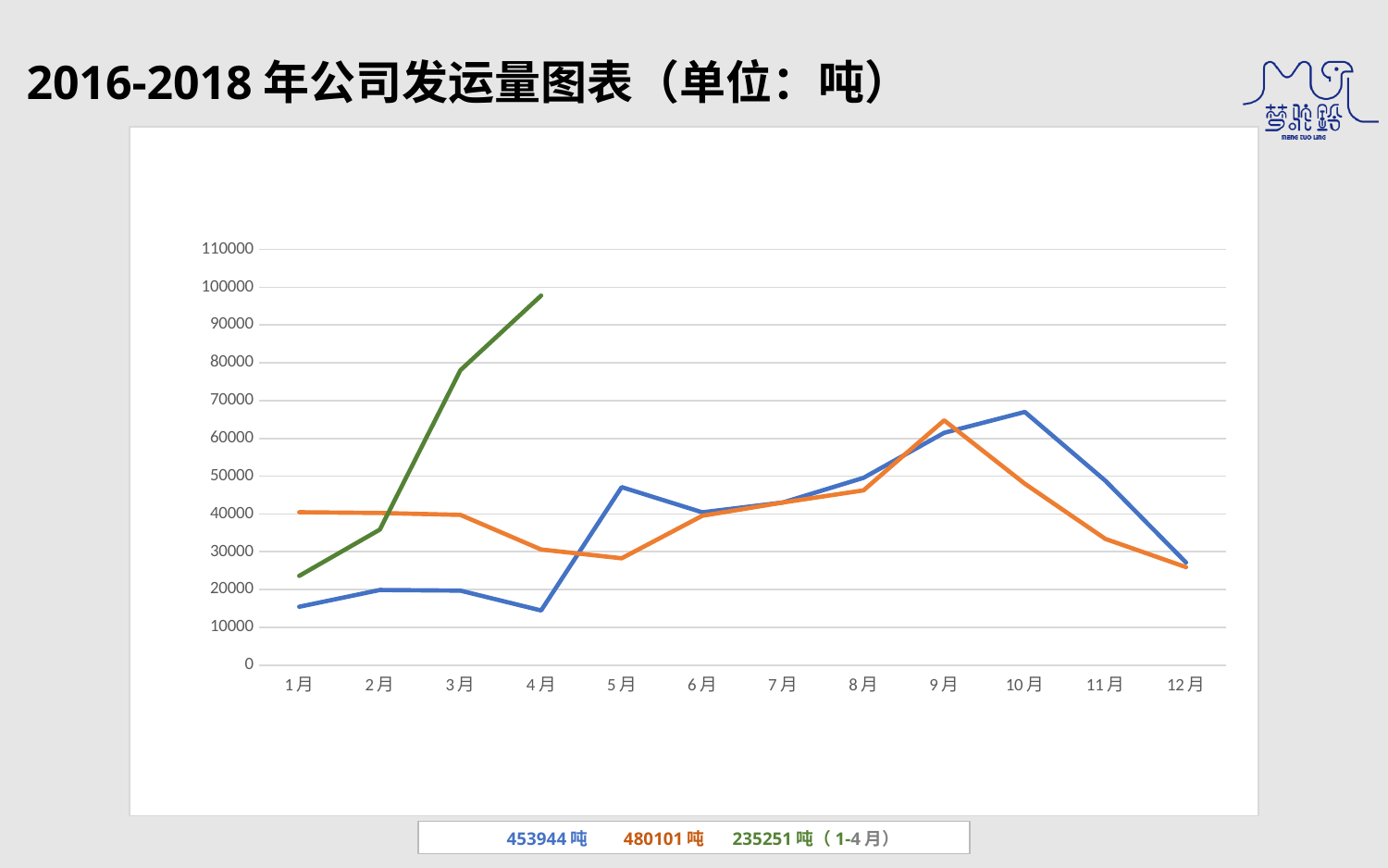
How many months are shown along the x axis of the chart? 12 How many lines are plotted on the chart? 3 In which month does the orange line reach its highest value? 9月 Is the value of the orange line at 1月 greater or less than 30000? greater Is the value of the orange line at 9月 greater or less than 60000? greater At 3月, which line has the higher value, the green line or the orange line? green line At 5月, which line has the higher value, the blue line or the orange line? blue line Is the value of the green line at 4月 greater or less than 90000? greater Does the green line rise or fall from 1月 to 4月? rise What kind of chart is shown on the slide? line chart In which month does the blue line reach its highest value? 10月